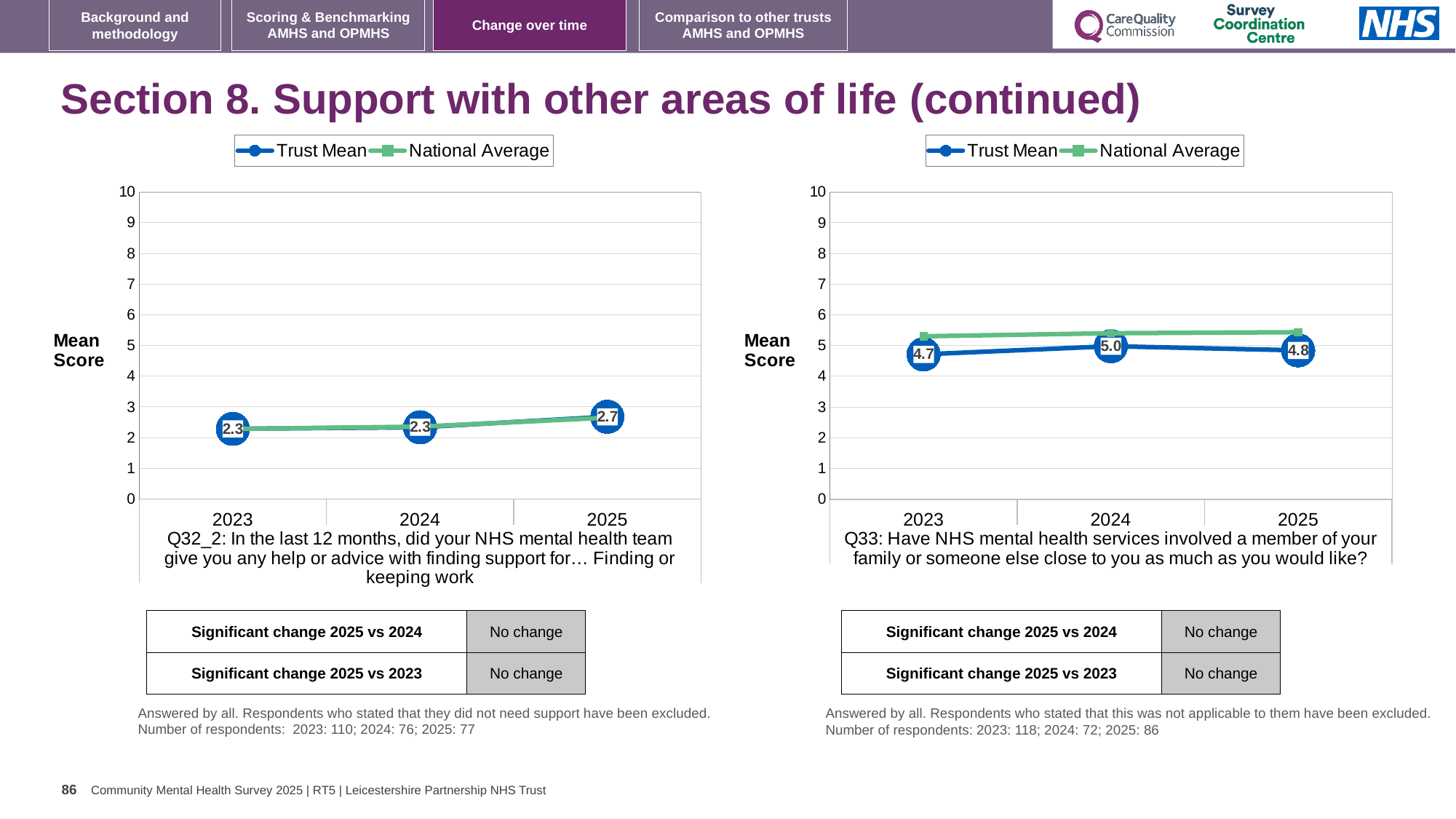
On the left chart (Q32_2), what is the difference between the Trust Mean in 2025 and in 2024? 0.4 On the left chart (Q32_2), which year has the highest Trust Mean? 2025 On the right chart (Q33), what is the difference between the Trust Mean in 2024 and in 2023? 0.3 On the right chart (Q33), is the Trust Mean for 2023 greater or less than 5? less On the right chart (Q33), which year has the lowest Trust Mean? 2023 On the left chart (Q32_2), what is the Trust Mean for 2025? 2.7 On the left chart (Q32_2), what is the Trust Mean for 2023? 2.3 How many years are plotted on the x axis of the right chart? 3 How many series does the legend of the left chart list? 2 On the right chart (Q33), what is the Trust Mean for 2024? 5.0 On the right chart (Q33), what is the Trust Mean for 2025? 4.8 What type of chart is used on the left side of the slide? Line chart